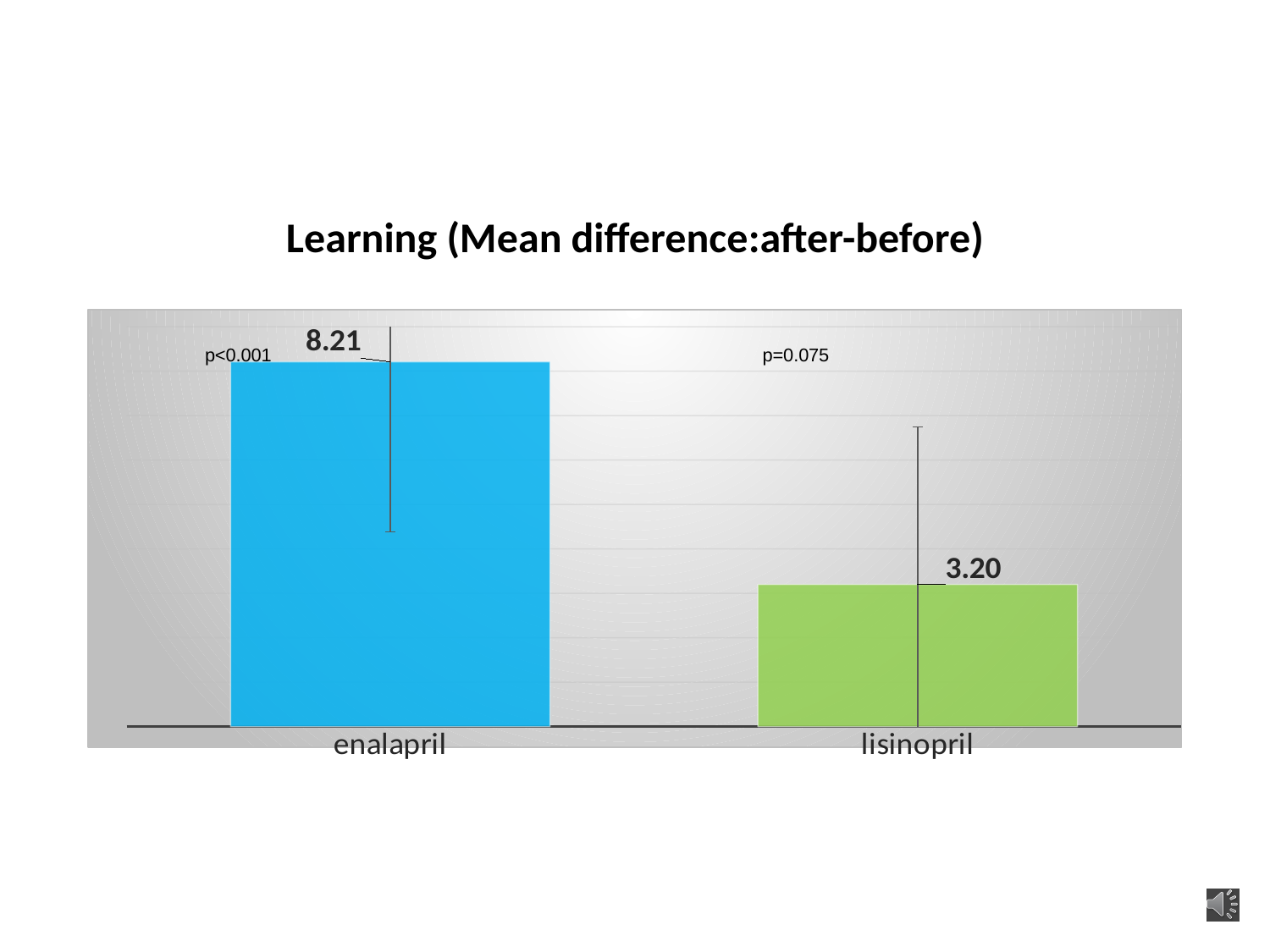
What is the value for enalapril? 8.21 Do the values rise or fall from enalapril to lisinopril? fall Which category has the highest value? enalapril Which category has the lowest value? lisinopril How many categories are shown on the chart? 2 What p-value is shown next to the enalapril bar? p<0.001 What is the difference between the values for enalapril and lisinopril? 5.01 What kind of chart is shown on the slide? bar chart Which is larger, the value for enalapril or the value for lisinopril? enalapril What is the title of the chart? Learning (Mean difference:after-before) What is the value for lisinopril? 3.20